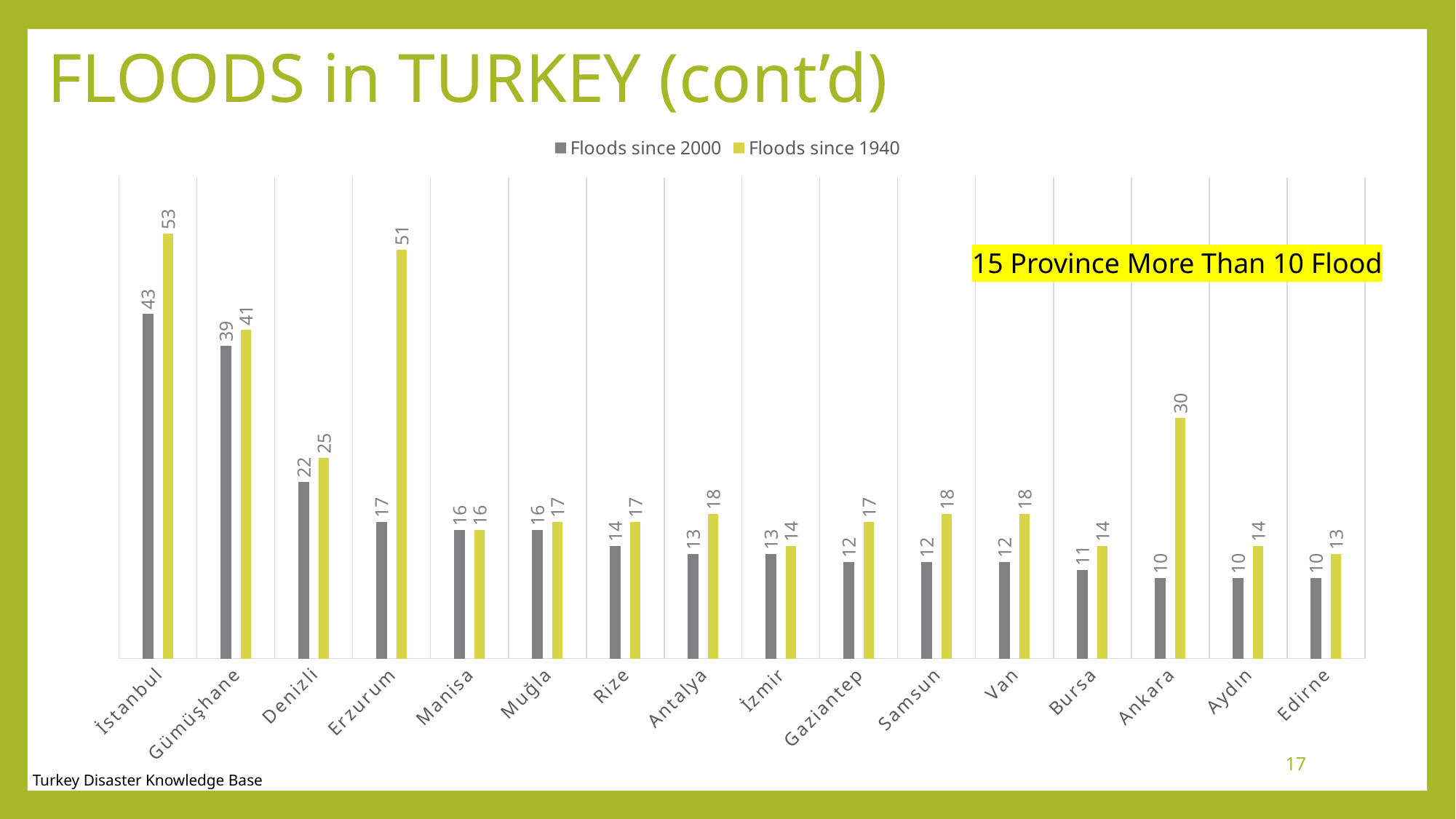
Which province has the lowest value for Floods since 1940? Edirne What kind of chart is shown on the slide? Bar chart How many series does the legend list? 2 What does the highlighted annotation on the chart say? 15 Province More Than 10 Flood What is the value of Floods since 2000 for Erzurum? 17 What is the difference between Floods since 1940 and Floods since 2000 for Erzurum? 34 Which is larger: Floods since 1940 for Gümüşhane or Floods since 1940 for Erzurum? Erzurum Do the values for Floods since 2000 generally rise or fall from İstanbul to Edirne? Fall Which province has the highest value for Floods since 2000? İstanbul What is the value of Floods since 1940 for İstanbul? 53 How many provinces are shown on the x axis? 16 What is the value of Floods since 1940 for Ankara? 30